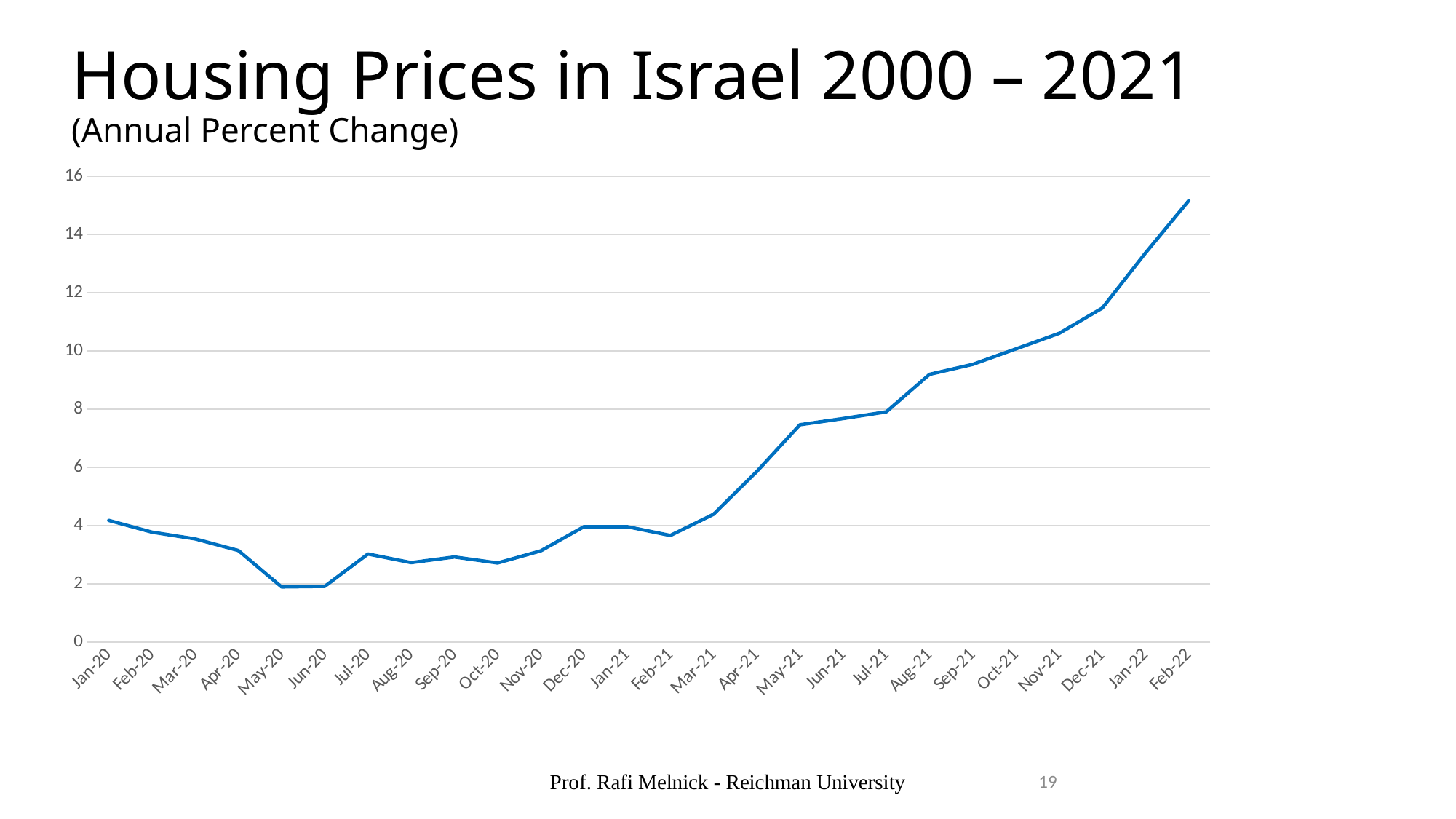
Is the value for Dec-21 greater or less than 10? greater Which is larger, the value for Dec-20 or the value for Jun-20? Dec-20 Is the value for Jul-20 greater or less than 2? greater Do the values rise or fall from Mar-21 to Feb-22? rise What kind of chart is shown on the slide? line chart Which is larger, the value for Feb-22 or the value for Jan-20? Feb-22 What is the title of the chart on the slide? Housing Prices in Israel 2000 – 2021 (Annual Percent Change) Is the value for May-21 greater or less than 6? greater How many monthly data points are plotted on the chart? 26 Which month has the highest annual percent change on the chart? Feb-22